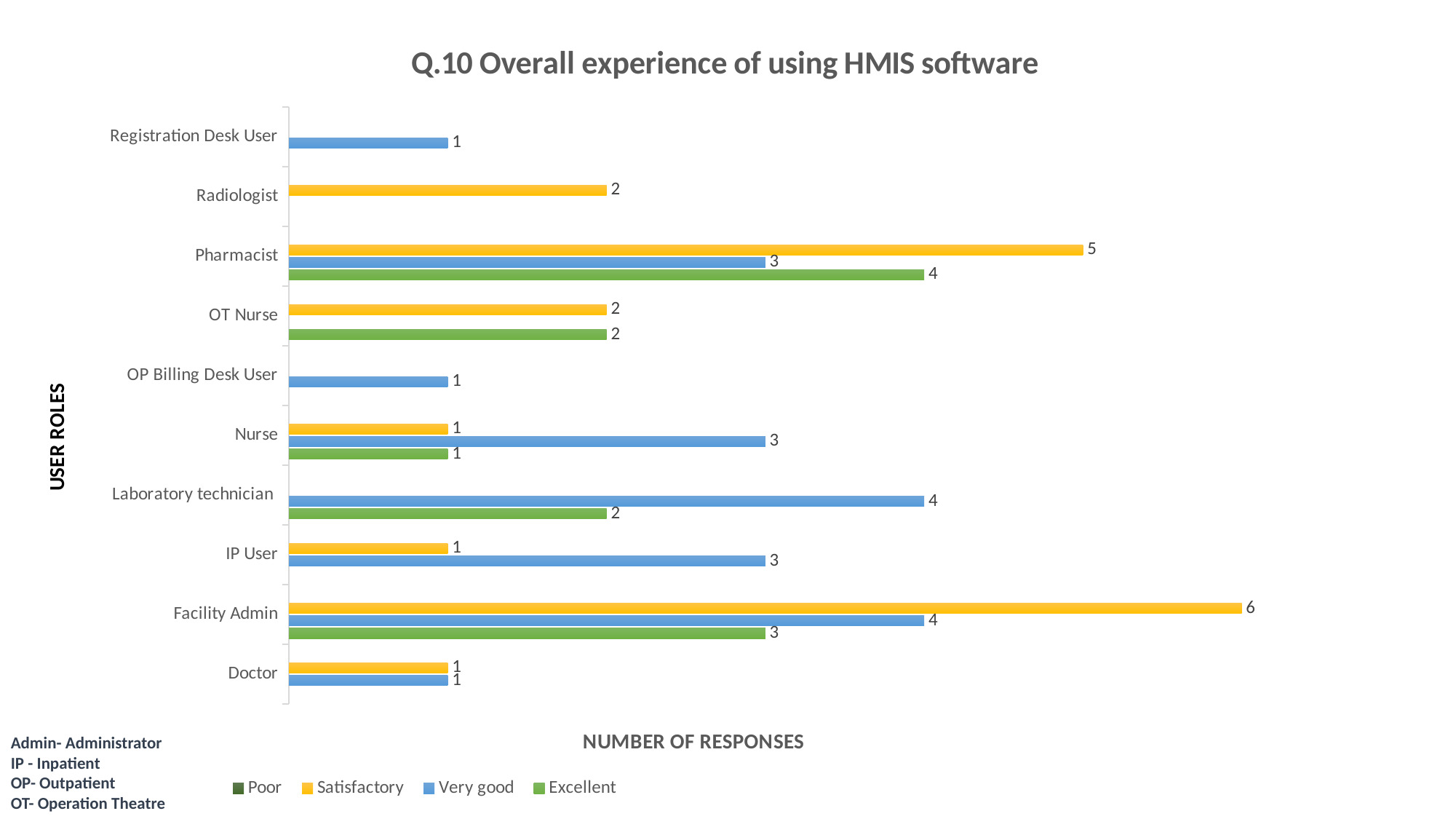
How many series does the legend list? 4 What is the total of the Satisfactory, Very good and Excellent values for Nurse? 5 How many user roles are listed on the y axis? 10 What is the Satisfactory value for Facility Admin? 6 What kind of chart is shown on the slide? Bar chart What is the label of the x axis? NUMBER OF RESPONSES Which is larger for Pharmacist: the Satisfactory value or the Very good value? Satisfactory What is the title of the chart? Q.10 Overall experience of using HMIS software What is the difference between the Satisfactory and Excellent values for Facility Admin? 3 Which user role has the highest Satisfactory value? Facility Admin What is the Very good value for Laboratory technician? 4 What is the Excellent value for Pharmacist? 4